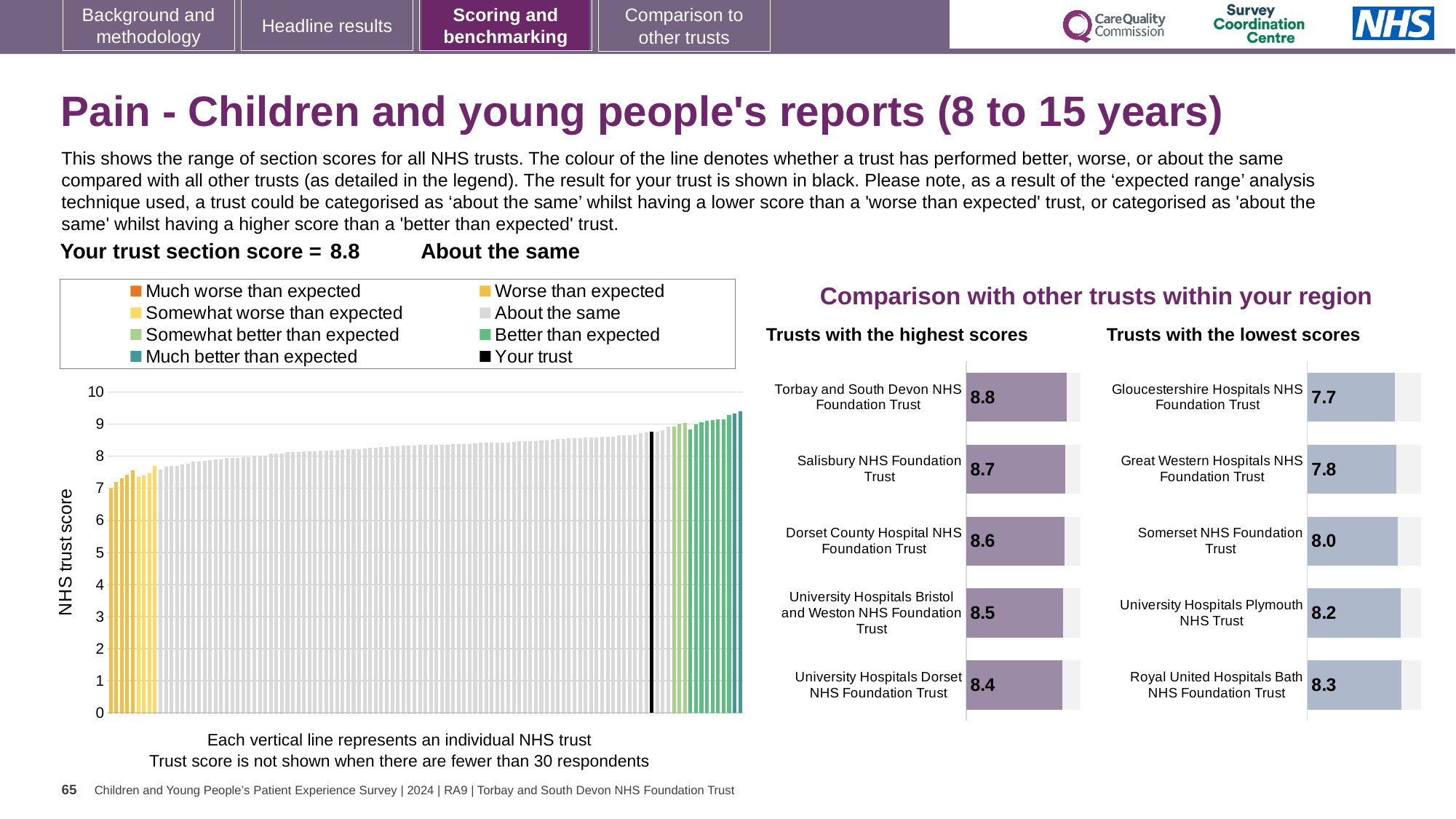
In the 'Trusts with the lowest scores' chart, what is the score for Somerset NHS Foundation Trust? 8.0 In the 'Trusts with the highest scores' chart, what is the difference between the scores of Torbay and South Devon NHS Foundation Trust and University Hospitals Dorset NHS Foundation Trust? 0.4 What is the y-axis label of the bar chart on the left of the slide? NHS trust score In the 'Trusts with the lowest scores' chart, which trust has the lowest score? Gloucestershire Hospitals NHS Foundation Trust How many entries does the legend of the NHS trust score chart on the left list? 8 In the NHS trust score chart on the left, is the value for the black 'Your trust' bar greater or less than 8? greater In the 'Trusts with the lowest scores' chart, which has the larger score: Great Western Hospitals NHS Foundation Trust or University Hospitals Plymouth NHS Trust? University Hospitals Plymouth NHS Trust In the 'Trusts with the highest scores' chart, what is the score for Salisbury NHS Foundation Trust? 8.7 In the 'Trusts with the highest scores' chart, which trust has the highest score? Torbay and South Devon NHS Foundation Trust How many trusts are shown in the 'Trusts with the highest scores' chart? 5 What kind of chart is the NHS trust score chart on the left of the slide? bar chart In the NHS trust score chart on the left, do the values rise or fall from left to right? rise